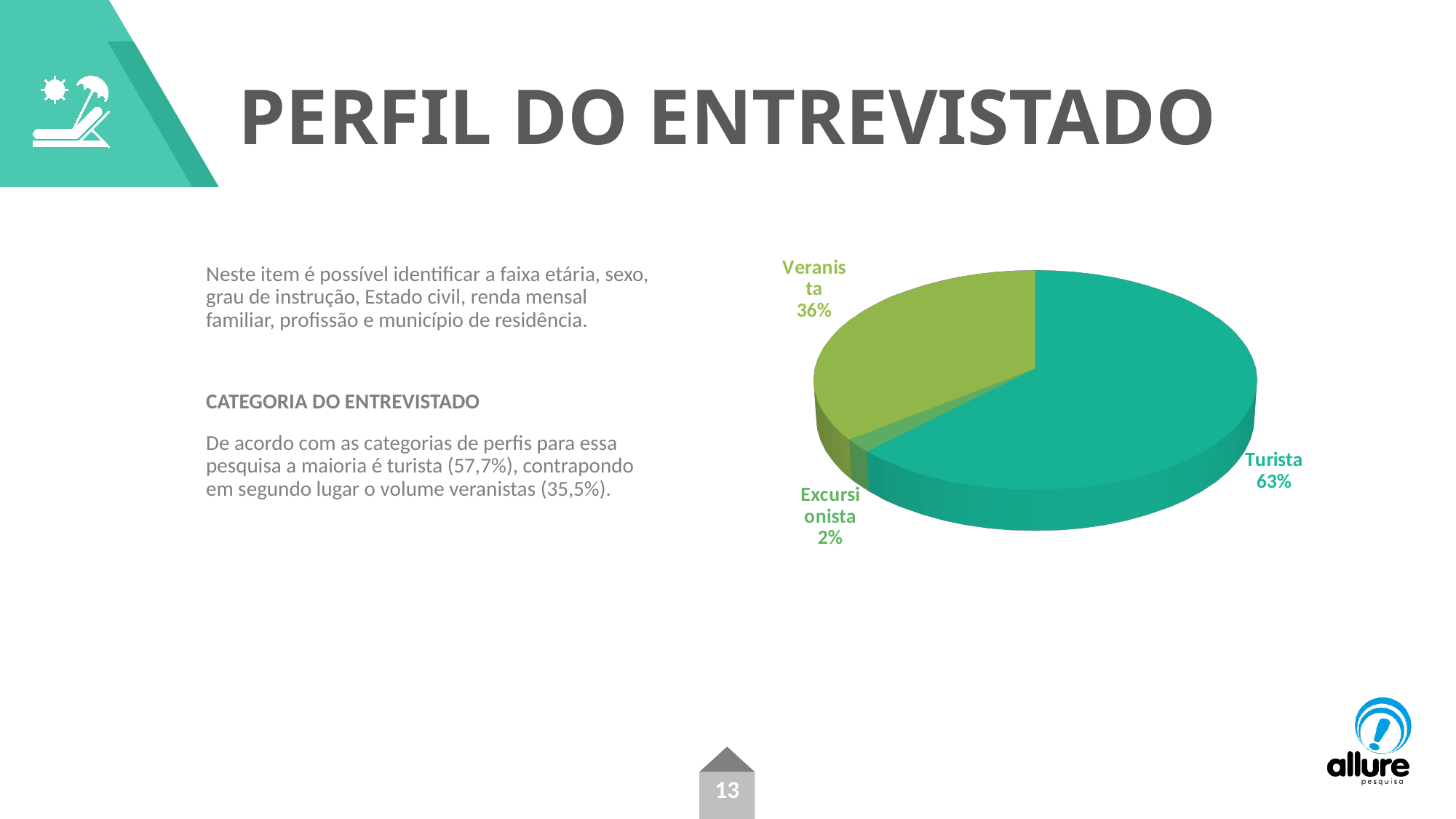
What share of the pie does Turista represent? 63% What is the difference in percentage points between Turista and Veranista? 27 What share of the pie does Excursionista represent? 2% Which is larger, the Veranista slice or the Excursionista slice? Veranista Which category has the smallest slice of the pie? Excursionista What colour is the Veranista slice? Green What share of the pie does Veranista represent? 36% How many categories are shown in the pie chart? 3 What kind of chart is shown on the slide? Pie chart Which category has the largest slice of the pie? Turista What is the difference in percentage points between Veranista and Excursionista? 34 What colour is the Turista slice? Teal